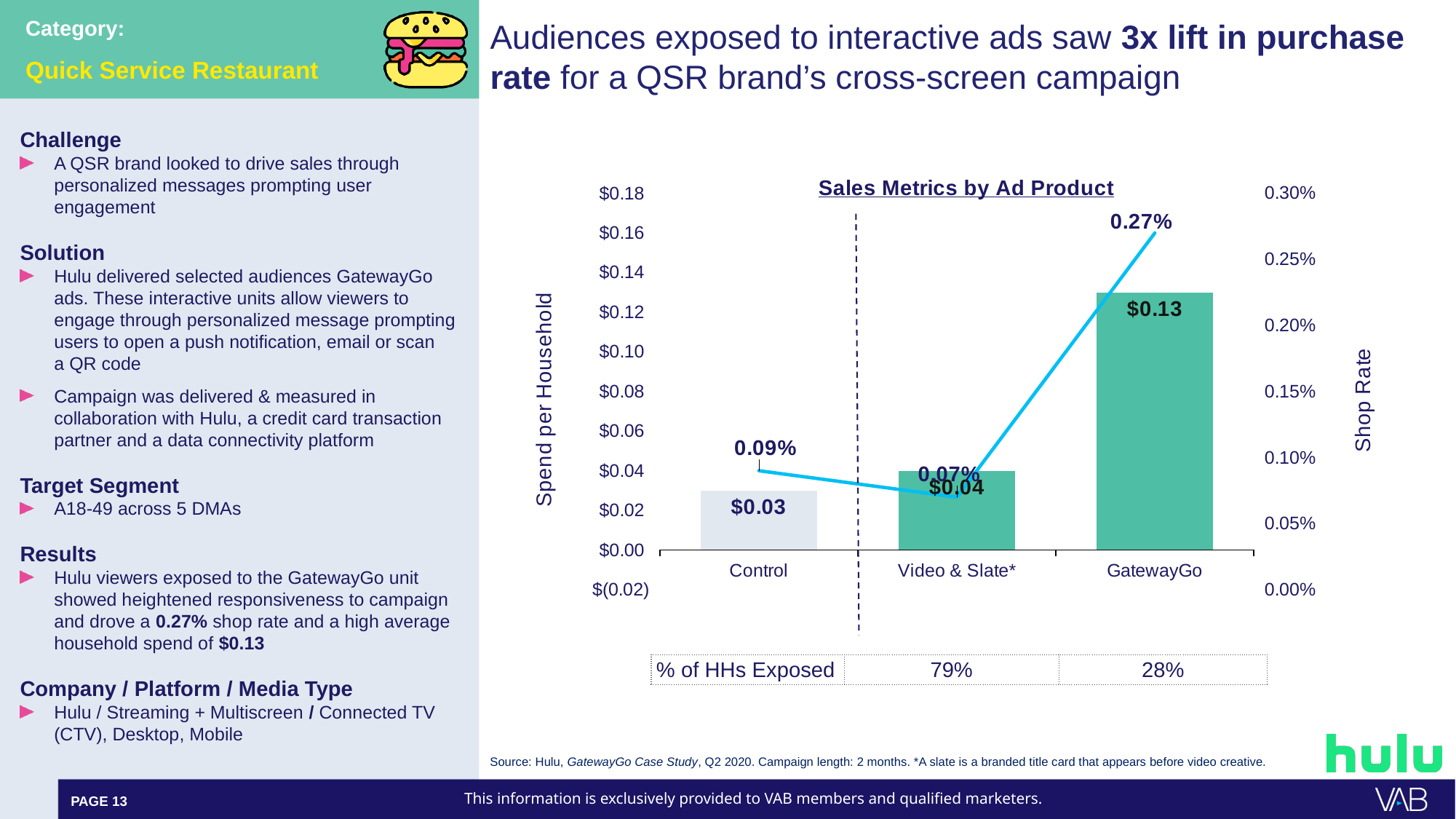
How many ad product categories are shown on the x axis? 3 What is the spend per household for Control? $0.03 What is the shop rate for Control? 0.09% What is the spend per household for GatewayGo? $0.13 Which has a higher shop rate, Control or Video & Slate*? Control What is the title of the chart? Sales Metrics by Ad Product Which ad product has the highest spend per household? GatewayGo Which ad product has the lowest shop rate? Video & Slate* What is the shop rate for GatewayGo? 0.27% What percentage of households were exposed to GatewayGo? 28% What is the difference in spend per household between GatewayGo and Control? $0.10 What is the spend per household for Video & Slate*? $0.04